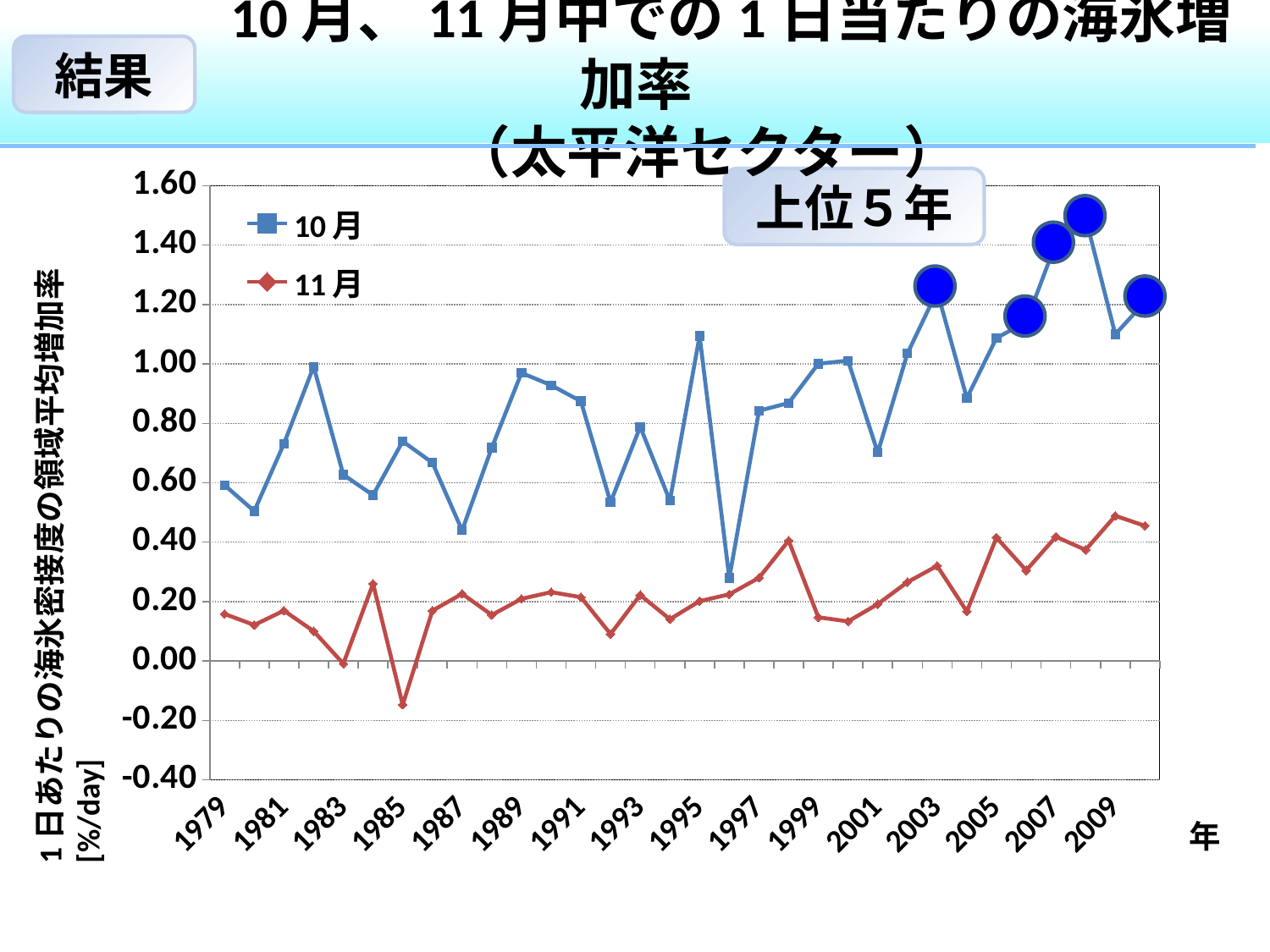
Which is larger, the 10月 value for 1995 or for 1996? 1995 Is the 10月 value for 1996 greater or less than 0.40? less In which year does the 10月 series reach its highest value? 2008 Is the 10月 value for 1979 greater or less than 0.40? greater Is the 11月 value for 2009 greater or less than 0.40? greater Which series generally has the higher values across the years, 10月 or 11月? 10月 What kind of chart is shown on the slide? line chart What unit is given in the y-axis label? %/day In which year does the 11月 series reach its lowest value? 1985 How many series does the legend list? 2 What are the two series named in the legend? 10月 and 11月